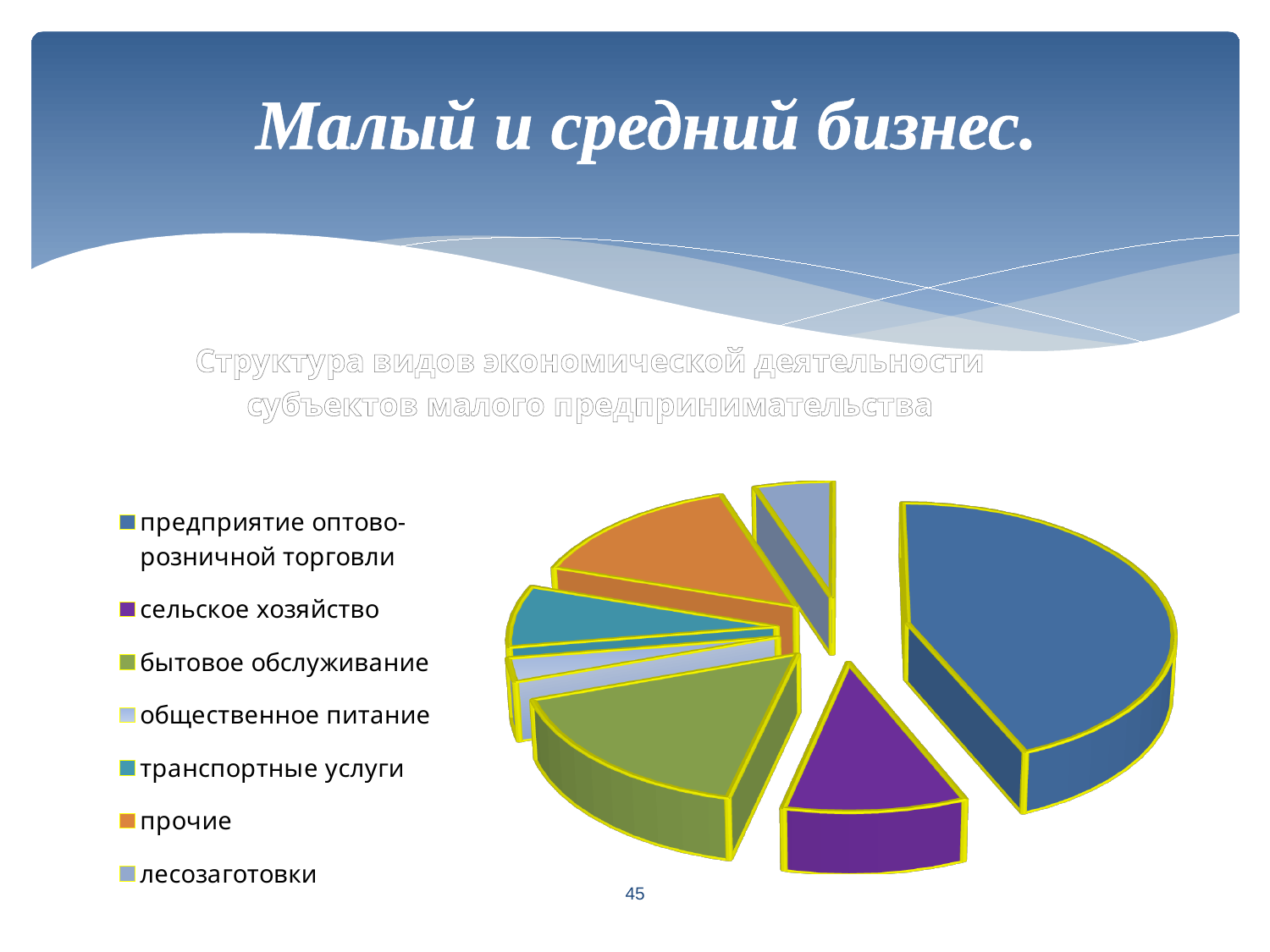
Which slice is larger: бытовое обслуживание or сельское хозяйство? бытовое обслуживание Which slice is larger: прочие or лесозаготовки? прочие What is the title of the chart? Структура видов экономической деятельности субъектов малого предпринимательства Which slice is larger: бытовое обслуживание or общественное питание? бытовое обслуживание What kind of chart is shown on the slide? pie chart Which category has the largest slice of the pie chart? предприятие оптово-розничной торговли How many categories does the pie chart's legend list? 7 What colour is the slice for сельское хозяйство? purple